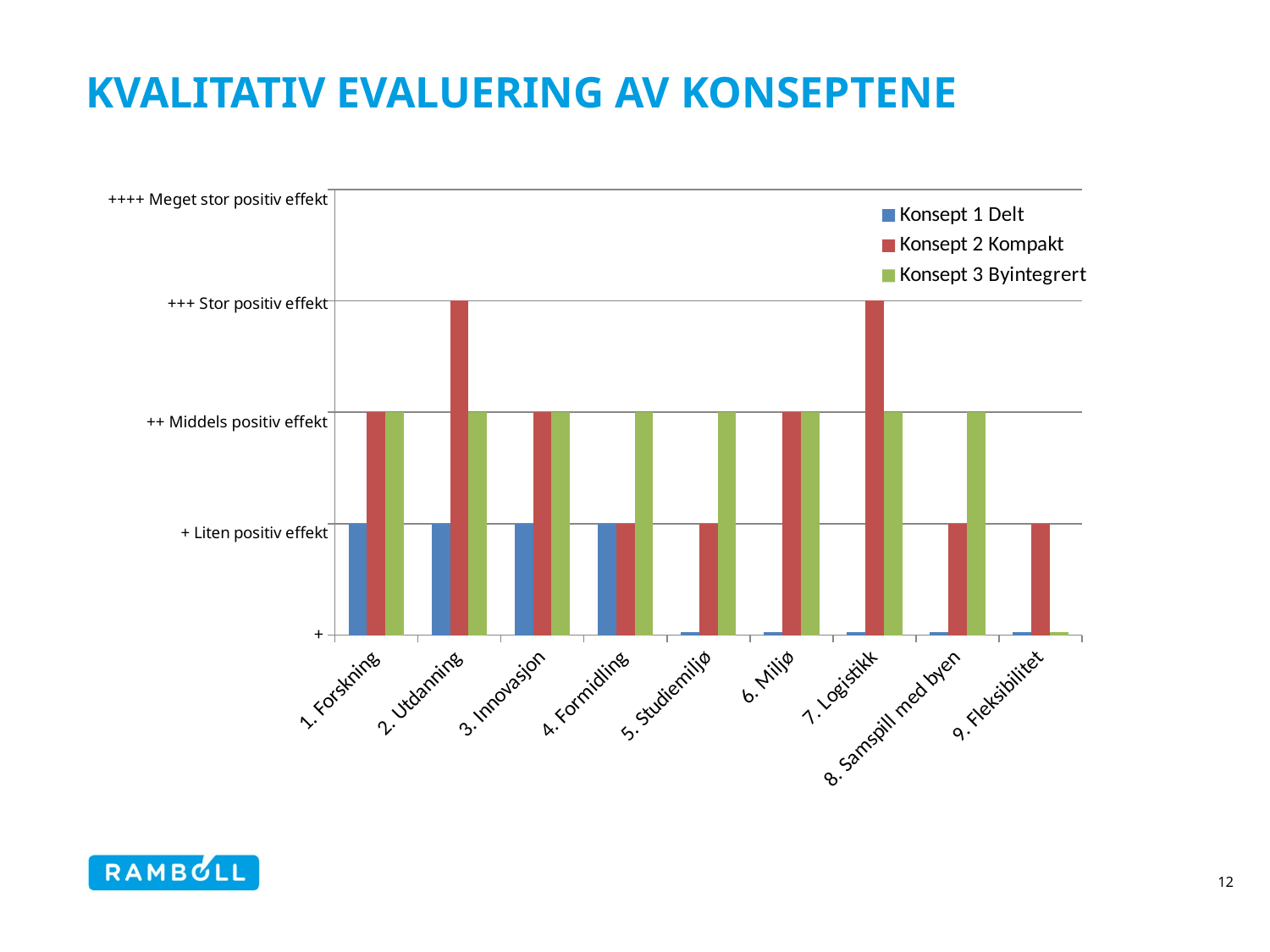
How many categories are shown along the x axis of the chart? 9 Which series has the highest rating for 2. Utdanning? Konsept 2 Kompakt How many series does the chart's legend list? 3 For 4. Formidling, which is rated higher: Konsept 2 Kompakt or Konsept 3 Byintegrert? Konsept 3 Byintegrert What rating does Konsept 3 Byintegrert receive for 5. Studiemiljø? ++ Middels positiv effekt What rating does Konsept 2 Kompakt receive for 2. Utdanning? +++ Stor positiv effekt What kind of chart is shown on the slide? Bar chart What is the title of the slide containing the chart? KVALITATIV EVALUERING AV KONSEPTENE What rating does Konsept 2 Kompakt receive for 7. Logistikk? +++ Stor positiv effekt What rating does Konsept 2 Kompakt receive for 8. Samspill med byen? + Liten positiv effekt What rating does Konsept 1 Delt receive for 1. Forskning? + Liten positiv effekt